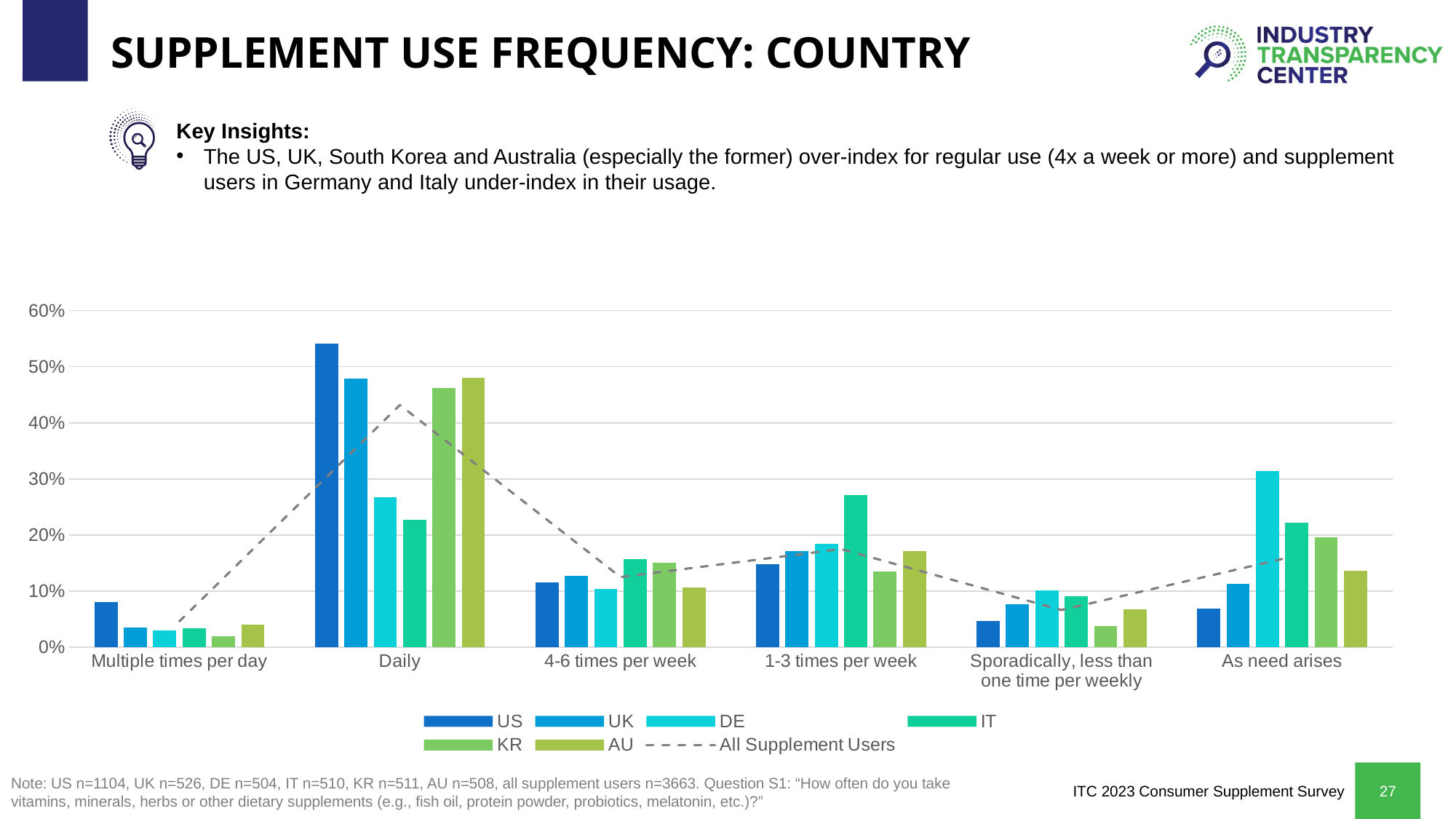
What does the dashed line in the chart represent? All Supplement Users Is the value for DE in the As need arises category greater or less than 30%? greater How many frequency categories are shown along the x axis? 6 Is the value for US in the Multiple times per day category greater or less than 10%? less How many series does the legend list? 7 Which country has the highest value for Daily? US In the As need arises category, which is larger, IT or KR? IT In the Daily category, which is larger, UK or DE? UK Which country has the highest value for 1-3 times per week? IT What kind of chart is shown on the slide? combination bar and line chart Is the value for US in the Daily category greater or less than 50%? greater Which country has the highest value for As need arises? DE